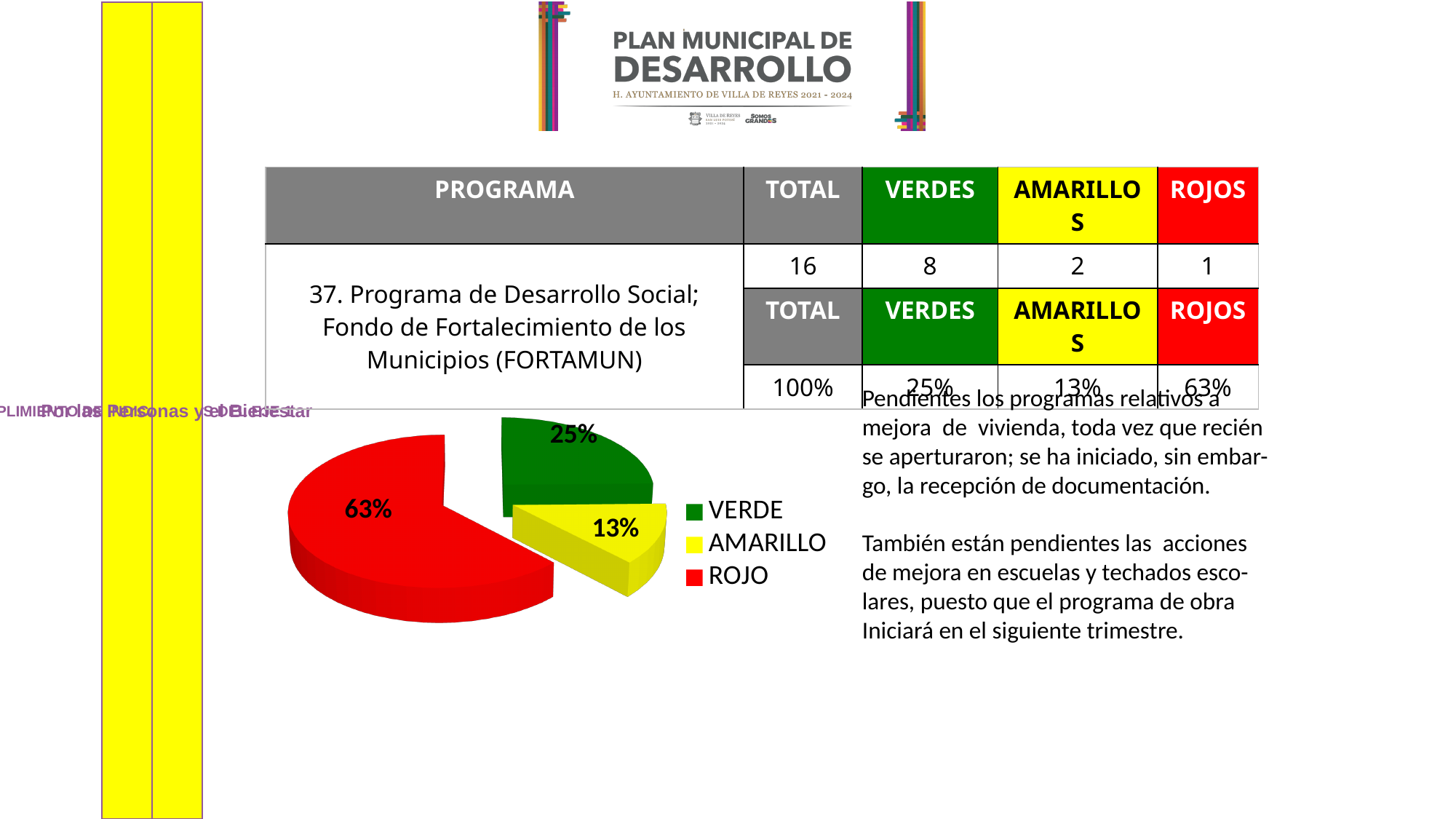
What share of the pie chart does the ROJO slice represent? 63% Which slice of the pie chart is the smallest? AMARILLO What colour is the ROJO slice in the pie chart? red How many slices does the pie chart have? 3 What kind of chart is shown on the slide? pie chart What share of the pie chart does the AMARILLO slice represent? 13% What are the three legend entries of the pie chart? VERDE, AMARILLO, ROJO How many entries does the pie chart legend list? 3 What is the difference in percentage points between the ROJO slice and the VERDE slice in the pie chart? 38 Which is larger in the pie chart, the VERDE slice or the AMARILLO slice? VERDE Which slice of the pie chart is the largest? ROJO What share of the pie chart does the VERDE slice represent? 25%